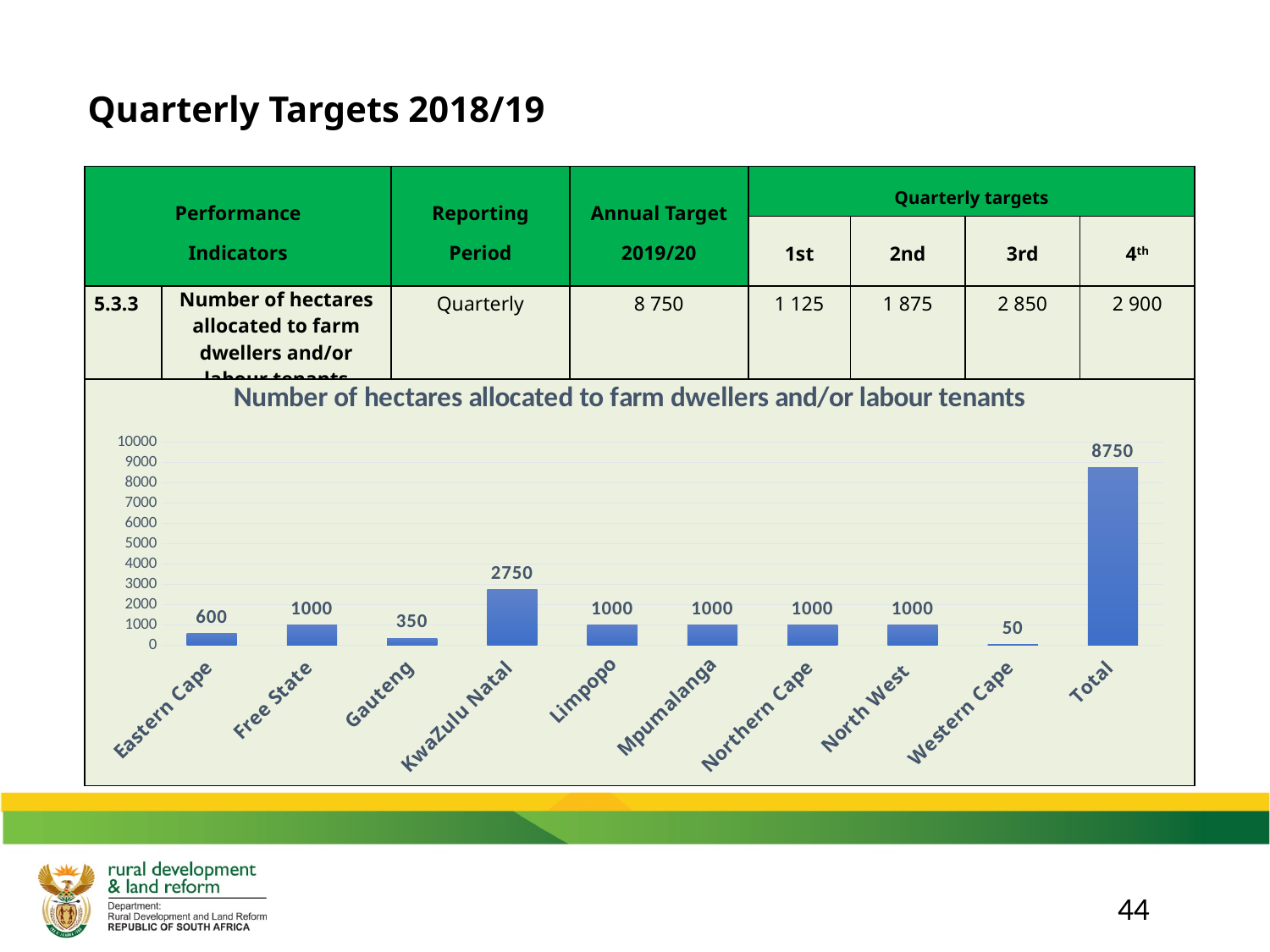
What is the value for Western Cape? 50 Which province has the lowest number of hectares? Western Cape What is the value for Eastern Cape? 600 What is the value of the Total bar? 8750 What kind of chart is shown? Bar chart Excluding the Total bar, which province has the highest number of hectares? KwaZulu Natal What is the difference between the values for KwaZulu Natal and Free State? 1750 What is the value for Gauteng? 350 What is the title of the chart? Number of hectares allocated to farm dwellers and/or labour tenants Which is larger, the value for Eastern Cape or the value for Gauteng? Eastern Cape What is the value for KwaZulu Natal? 2750 How many bars are plotted in the chart, including the Total bar? 10